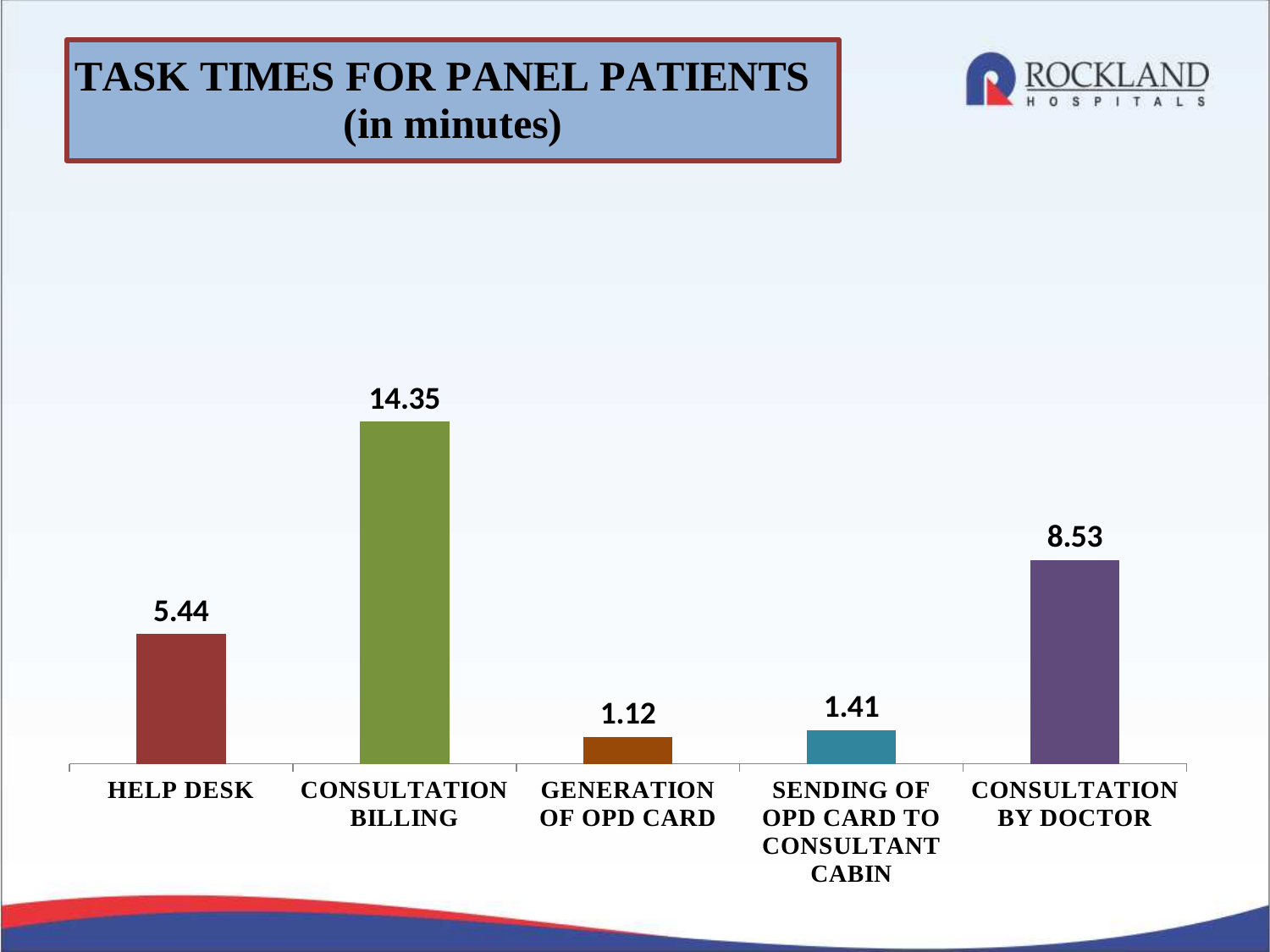
Which task has the lowest time? GENERATION OF OPD CARD What is the title of the chart? TASK TIMES FOR PANEL PATIENTS (in minutes) Which task has the highest time? CONSULTATION BILLING What is the task time for GENERATION OF OPD CARD? 1.12 What is the difference between the task times for CONSULTATION BILLING and CONSULTATION BY DOCTOR? 5.82 What is the task time for HELP DESK? 5.44 How many tasks are shown in the chart? 5 Which is larger, the task time for HELP DESK or for CONSULTATION BY DOCTOR? CONSULTATION BY DOCTOR What kind of chart is shown on the slide? Bar chart What is the task time for CONSULTATION BY DOCTOR? 8.53 What is the task time for CONSULTATION BILLING? 14.35 What is the task time for SENDING OF OPD CARD TO CONSULTANT CABIN? 1.41